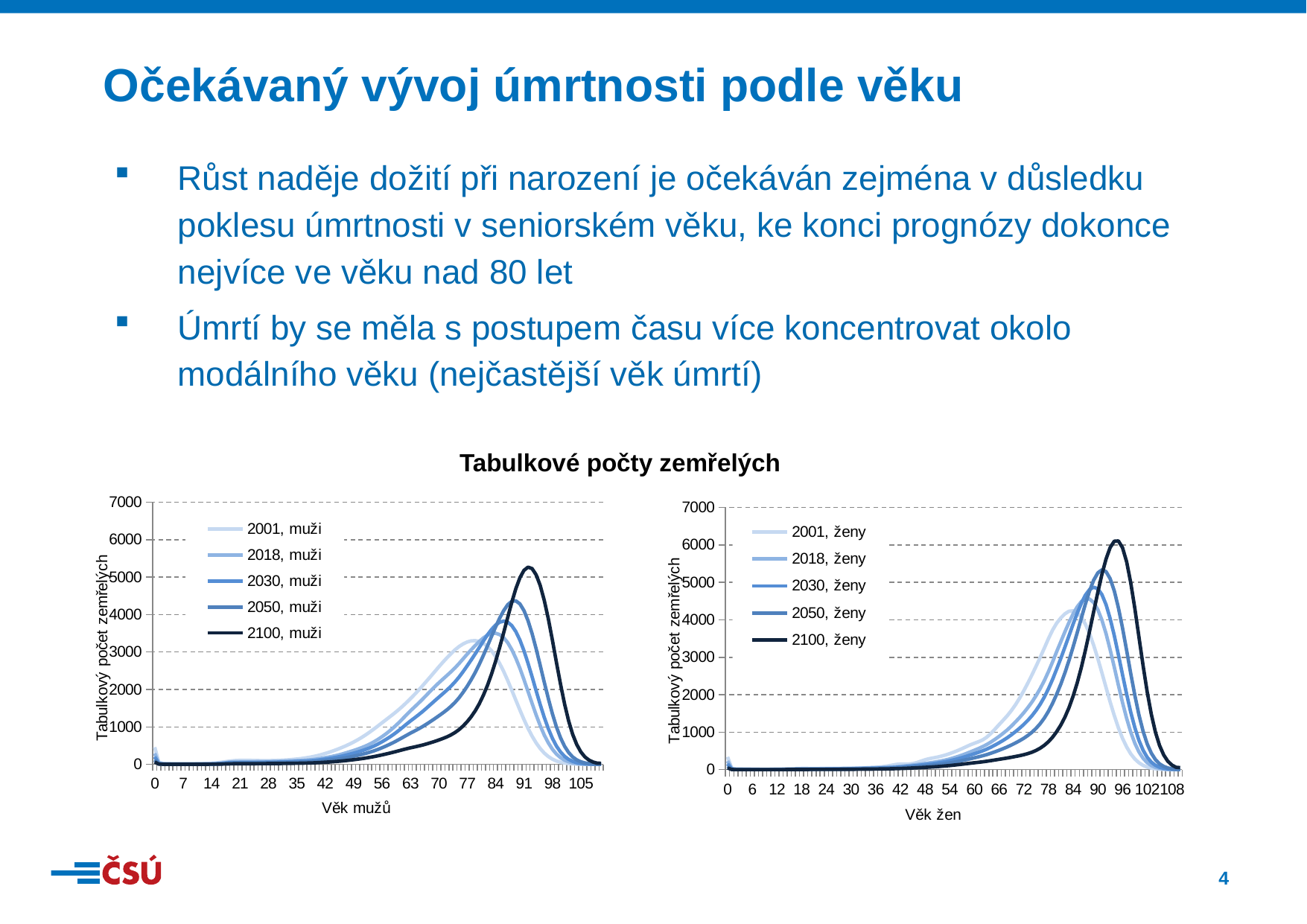
In the left chart (Věk mužů), is the peak value of the 2001, muži series greater or less than 4000? less How many series does the legend of the right chart (Věk žen) list? 5 How many series does the legend of the left chart (Věk mužů) list? 5 In the right chart (Věk žen), which series has the larger peak: 2001, ženy or 2100, ženy? 2100, ženy In the right chart (Věk žen), which series reaches the highest peak? 2100, ženy In the right chart (Věk žen), which series has the lowest peak? 2001, ženy What is the shared title above the two charts? Tabulkové počty zemřelých What is the x-axis title of the right chart? Věk žen What kind of chart is the left chart (Věk mužů)? line chart In the left chart (Věk mužů), is the peak value of the 2100, muži series greater or less than 5000? greater In the left chart (Věk mužů), which series reaches the highest peak? 2100, muži